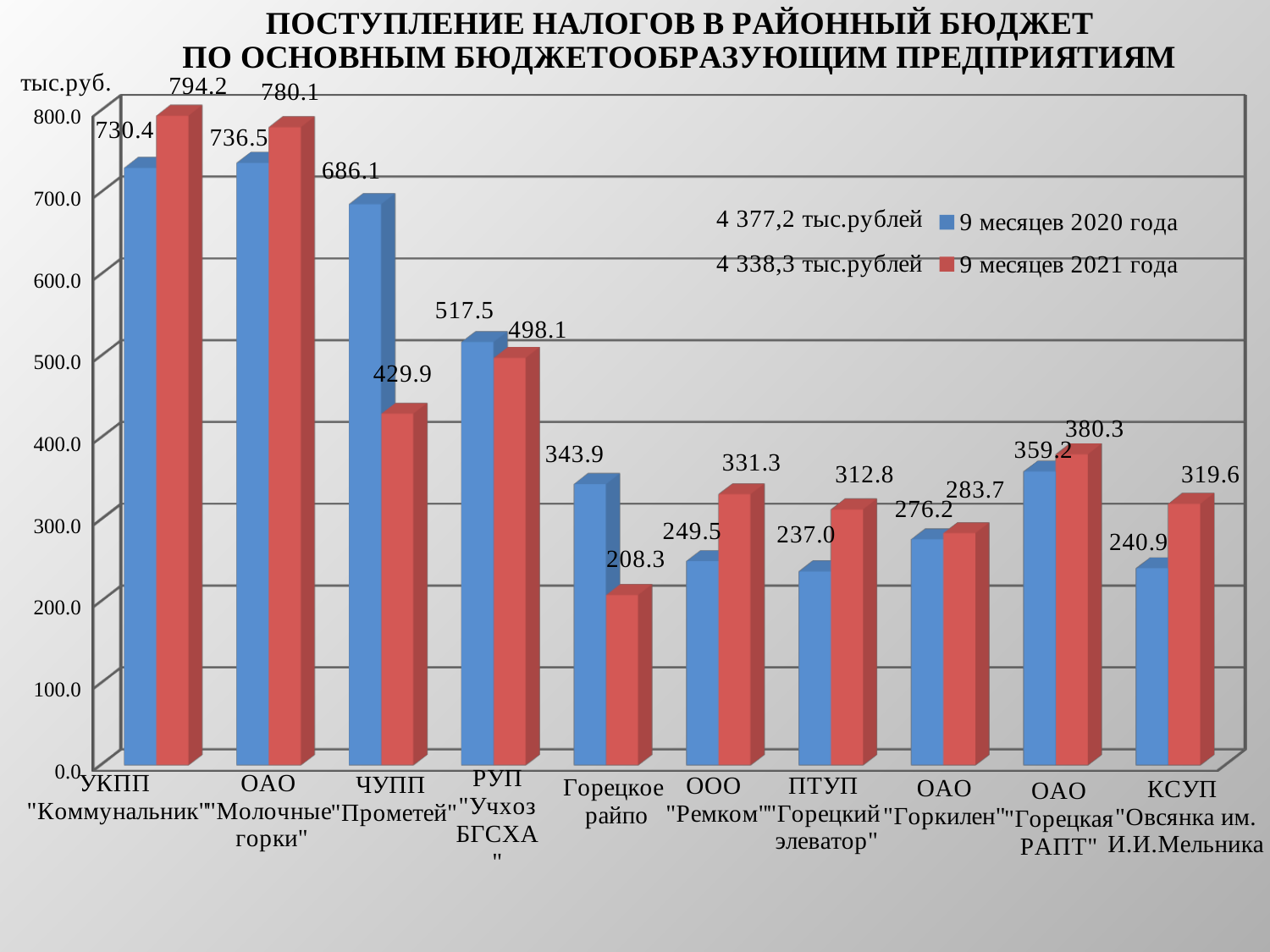
Which category has the highest value in the 9 месяцев 2021 года series? УКПП "Коммунальник" How many series does the legend list? 2 What kind of chart is shown on the slide? Bar chart What is the difference between the 2021 and 2020 values for ООО "Ремком"? 81.8 Which category has the lowest value in the 9 месяцев 2021 года series? Горецкое райпо For Горецкое райпо, which series has the larger value: 9 месяцев 2020 года or 9 месяцев 2021 года? 9 месяцев 2020 года What is the value for ЧУПП "Прометей" in the 9 месяцев 2021 года series? 429.9 What is the value for КСУП "Овсянка им. И.И.Мельника" in the 9 месяцев 2021 года series? 319.6 Which category has the lowest value in the 9 месяцев 2020 года series? ПТУП "Горецкий элеватор" How many enterprises (categories) are shown on the x axis? 10 What is the difference between the 2020 and 2021 values for ЧУПП "Прометей"? 256.2 What is the value for ПТУП "Горецкий элеватор" in the 9 месяцев 2020 года series? 237.0